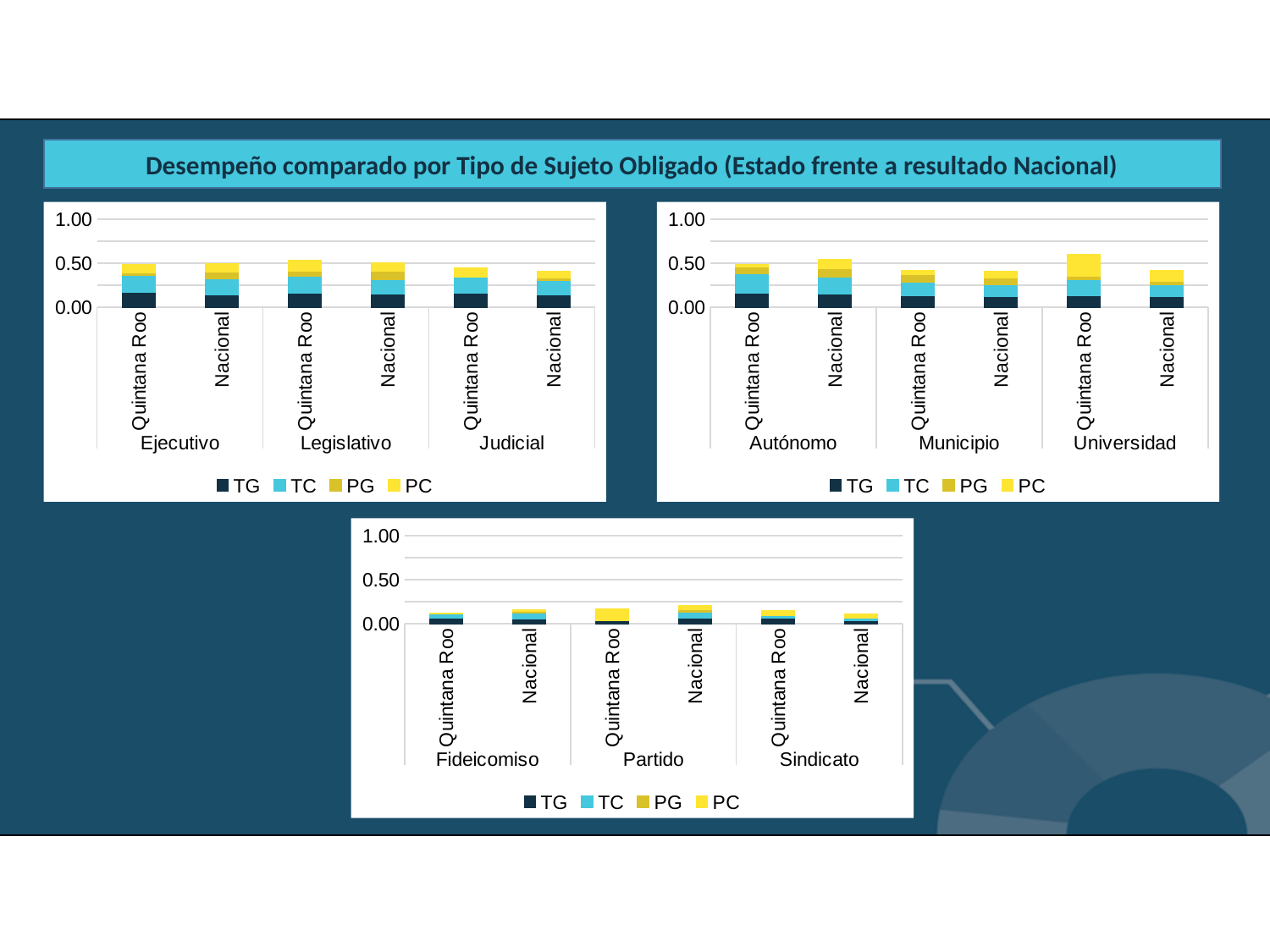
In the top-right chart, which bar has the highest total? Universidad, Quintana Roo In the top-right chart, which has the larger total: Universidad Quintana Roo or Universidad Nacional? Universidad Quintana Roo In the bottom chart, what are the legend entries? TG, TC, PG, PC In the bottom chart, is the total for Fideicomiso Quintana Roo greater or less than 0.50? less In the top-left chart, how many bars are plotted? 6 What is the title shown above the charts on the slide? Desempeño comparado por Tipo de Sujeto Obligado (Estado frente a resultado Nacional) In the top-right chart, is the total for Municipio Nacional greater or less than 0.50? less In the bottom chart, how many category groups are shown on the x axis? 3 In the top-left chart, how many series does the legend list? 4 What kind of chart is the top-right chart? Stacked bar chart In the top-right chart, is the total for Universidad Quintana Roo greater or less than 0.50? greater